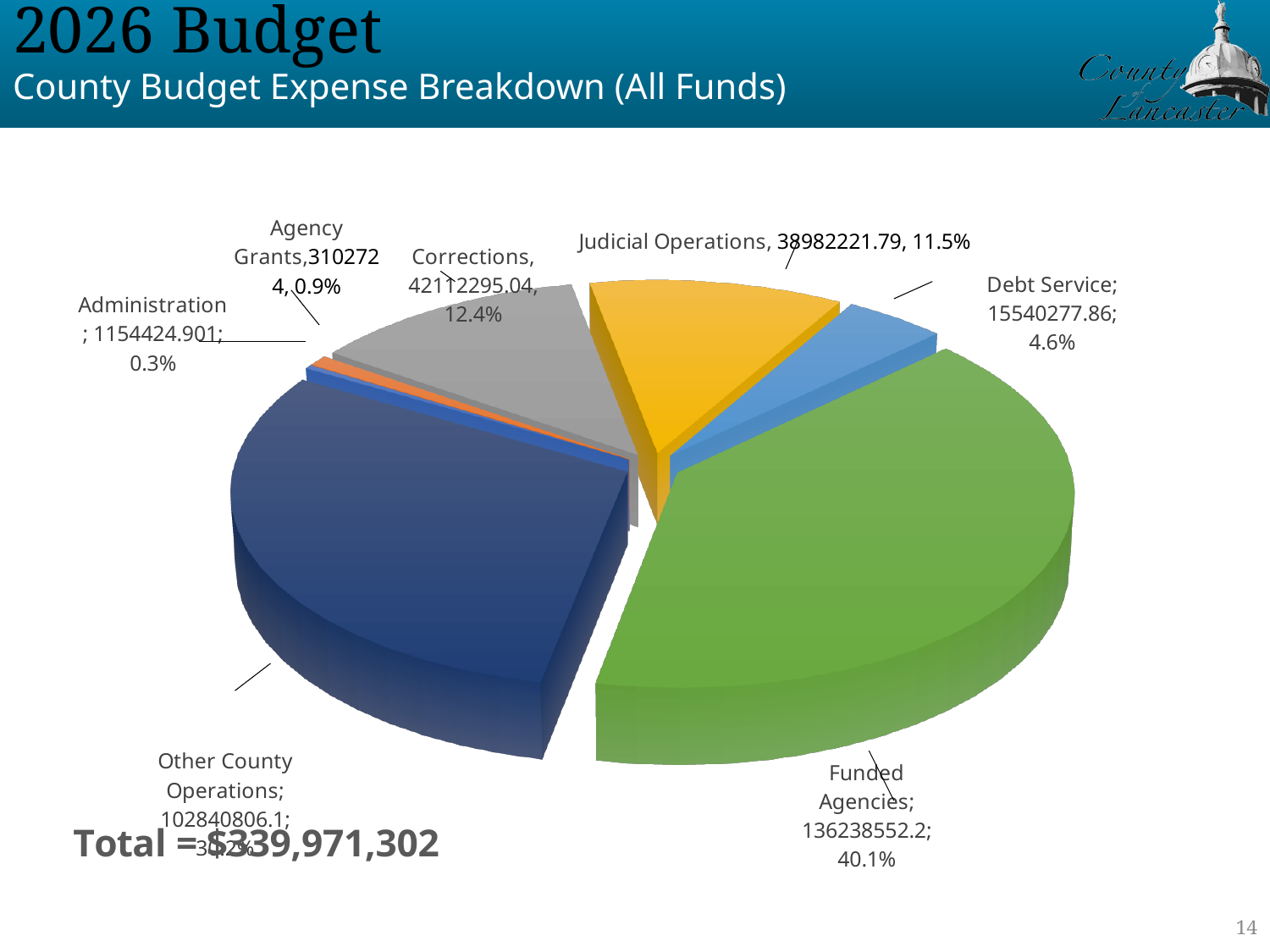
What kind of chart is shown on the slide? pie chart What percentage share does Funded Agencies have? 40.1% What percentage share does Corrections have? 12.4% What is the value shown for Other County Operations? 102840806.1 What is the difference in percentage share between Funded Agencies and Corrections? 27.7% Which has a larger share, Corrections or Judicial Operations? Corrections What is the value shown for Debt Service? 15540277.86 How many categories are shown in the pie chart? 7 Which category has the smallest share of the pie? Administration Which category has the largest share of the pie? Funded Agencies What is the value shown for Judicial Operations? 38982221.79